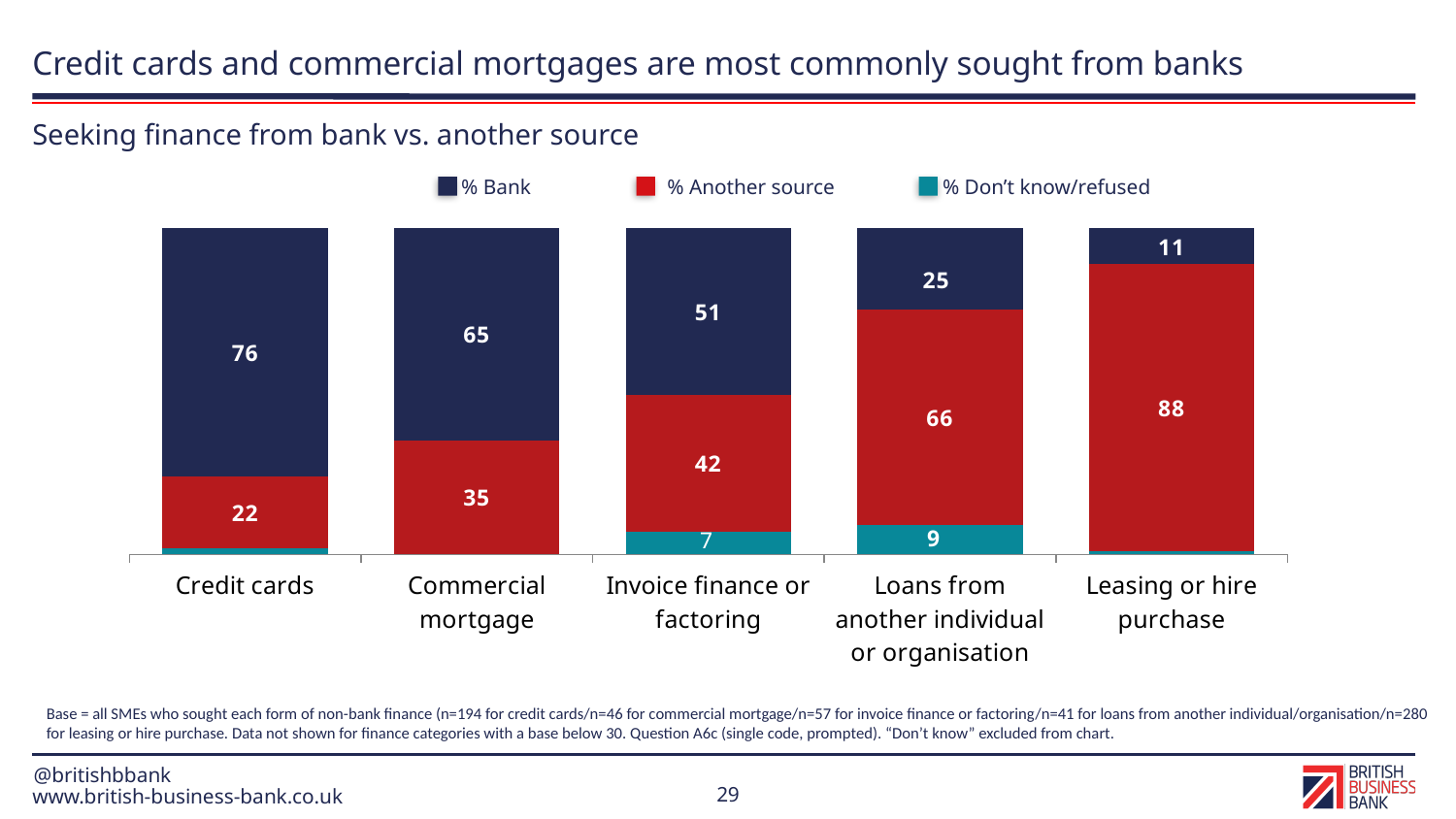
What is the difference between the % Bank values for Credit cards and Commercial mortgage? 11 What is the total of the stacked bar for Invoice finance or factoring? 100 How many finance categories are shown on the x axis? 5 What is the % Another source value for Leasing or hire purchase? 88 Which category has the lowest % Bank value? Leasing or hire purchase How many series does the legend list? 3 What is the % Don't know/refused value for Invoice finance or factoring? 7 Which is larger for Loans from another individual or organisation: the % Bank value or the % Another source value? % Another source What is the title of the chart? Seeking finance from bank vs. another source Which category has the highest % Bank value? Credit cards What is the % Bank value for Credit cards? 76 What type of chart is shown on the slide? Stacked bar chart